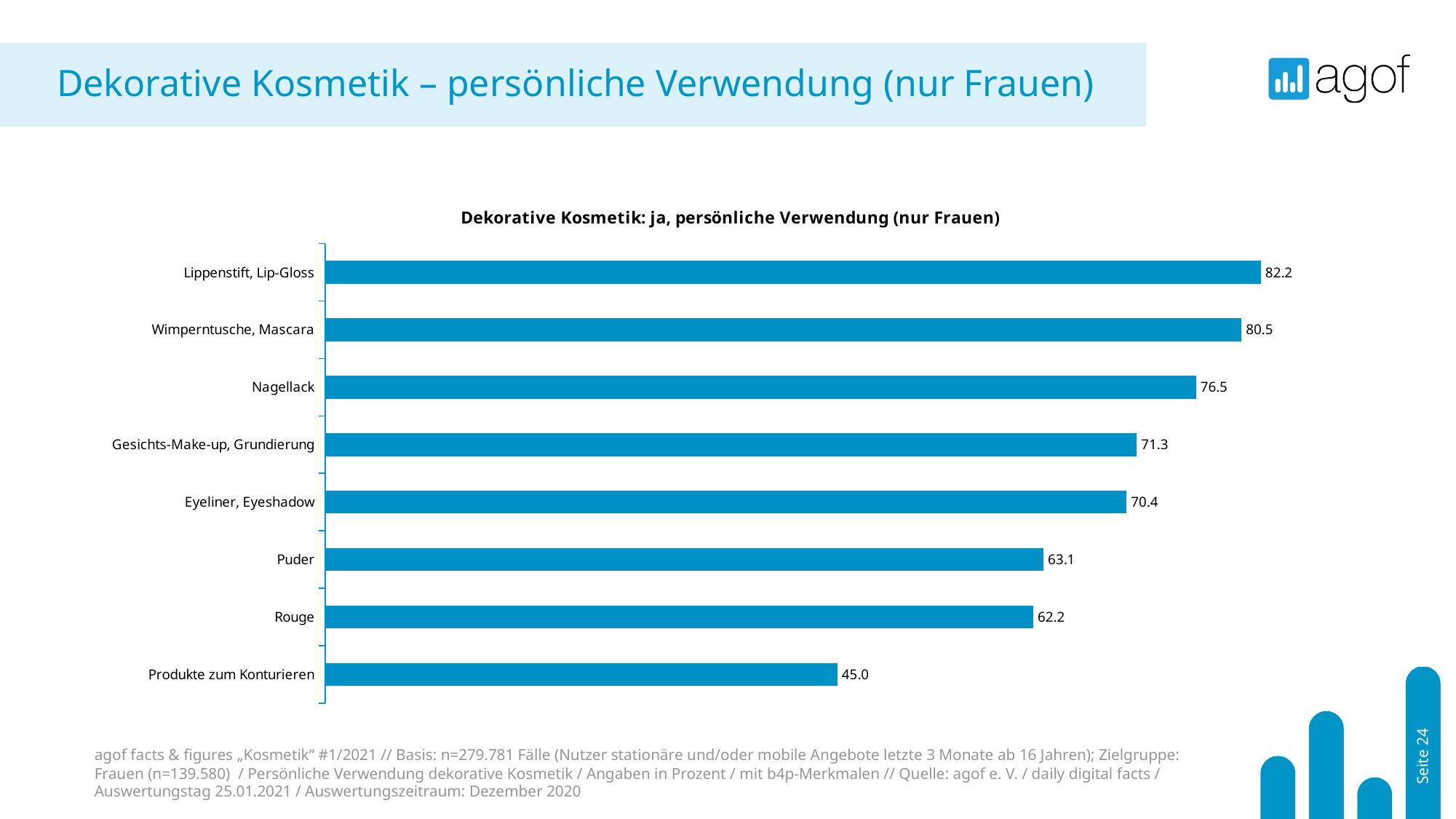
Which category has the highest value? Lippenstift, Lip-Gloss What is the value for Lippenstift, Lip-Gloss? 82.2 What kind of chart is shown on the slide? Bar chart What is the value for Puder? 63.1 What is the difference between the values for Lippenstift, Lip-Gloss and Produkte zum Konturieren? 37.2 What is the value for Produkte zum Konturieren? 45.0 Which category has the lowest value? Produkte zum Konturieren What is the title of the chart? Dekorative Kosmetik: ja, persönliche Verwendung (nur Frauen) How many categories are shown in the chart? 8 Which has a larger value, Wimperntusche, Mascara or Eyeliner, Eyeshadow? Wimperntusche, Mascara What is the value for Nagellack? 76.5 What is the difference between the values for Nagellack and Gesichts-Make-up, Grundierung? 5.2